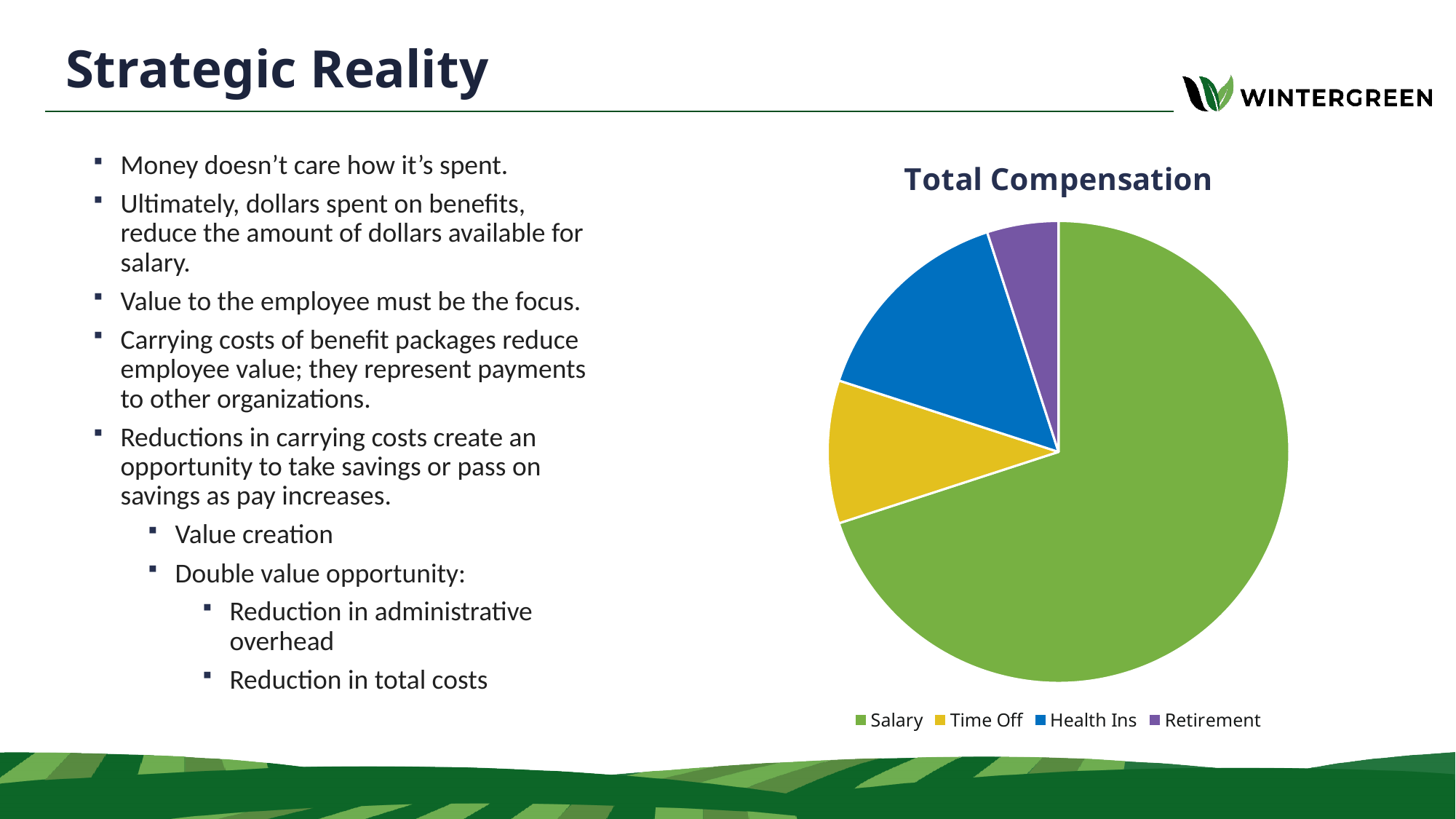
Which slice is larger, Salary or Health Ins? Salary Which category has the largest slice of the pie? Salary Which slice is larger, Time Off or Retirement? Time Off Which slice is larger, Health Ins or Time Off? Health Ins How many entries does the chart legend list? 4 Which category is shown in purple in the pie chart? Retirement How many slices does the pie chart have? 4 What is the title of the chart? Total Compensation Which category has the smallest slice of the pie? Retirement What kind of chart is shown on the slide? Pie chart